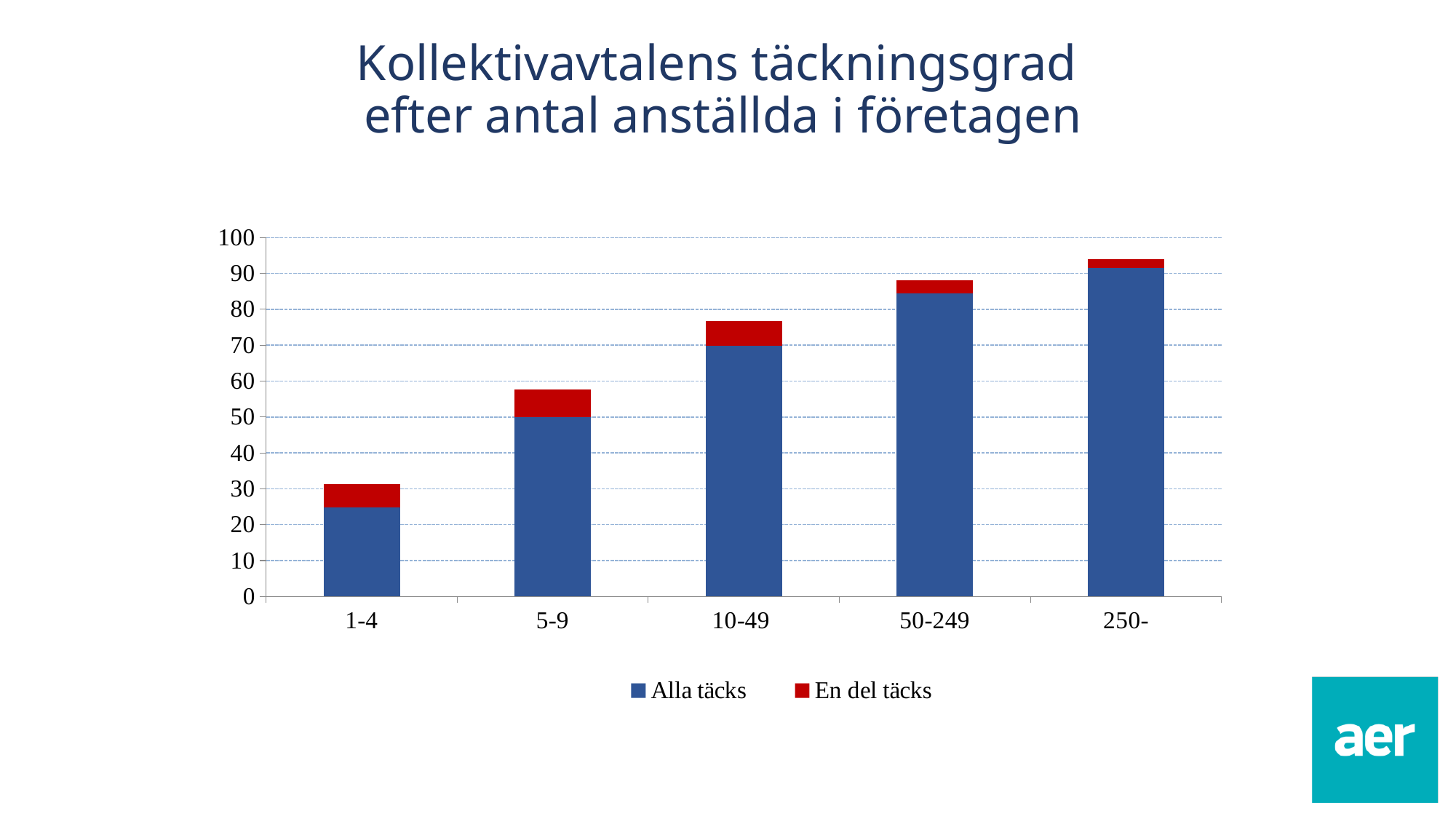
What kind of chart is shown on the slide? bar chart Is the 'Alla täcks' value for 50-249 greater or less than 80? greater How many categories are shown on the x axis of the chart? 5 Is the total stacked bar for 5-9 greater or less than 60? less Which category has the lowest total bar? 1-4 Is the 'Alla täcks' value for 250- greater or less than 90? greater Which series is shown in red in the legend? En del täcks Do the total bar heights rise or fall from left to right along the x axis? rise Which is larger, the 'Alla täcks' value for 5-9 or for 10-49? 10-49 Which category has the highest total bar? 250- How many series does the legend list? 2